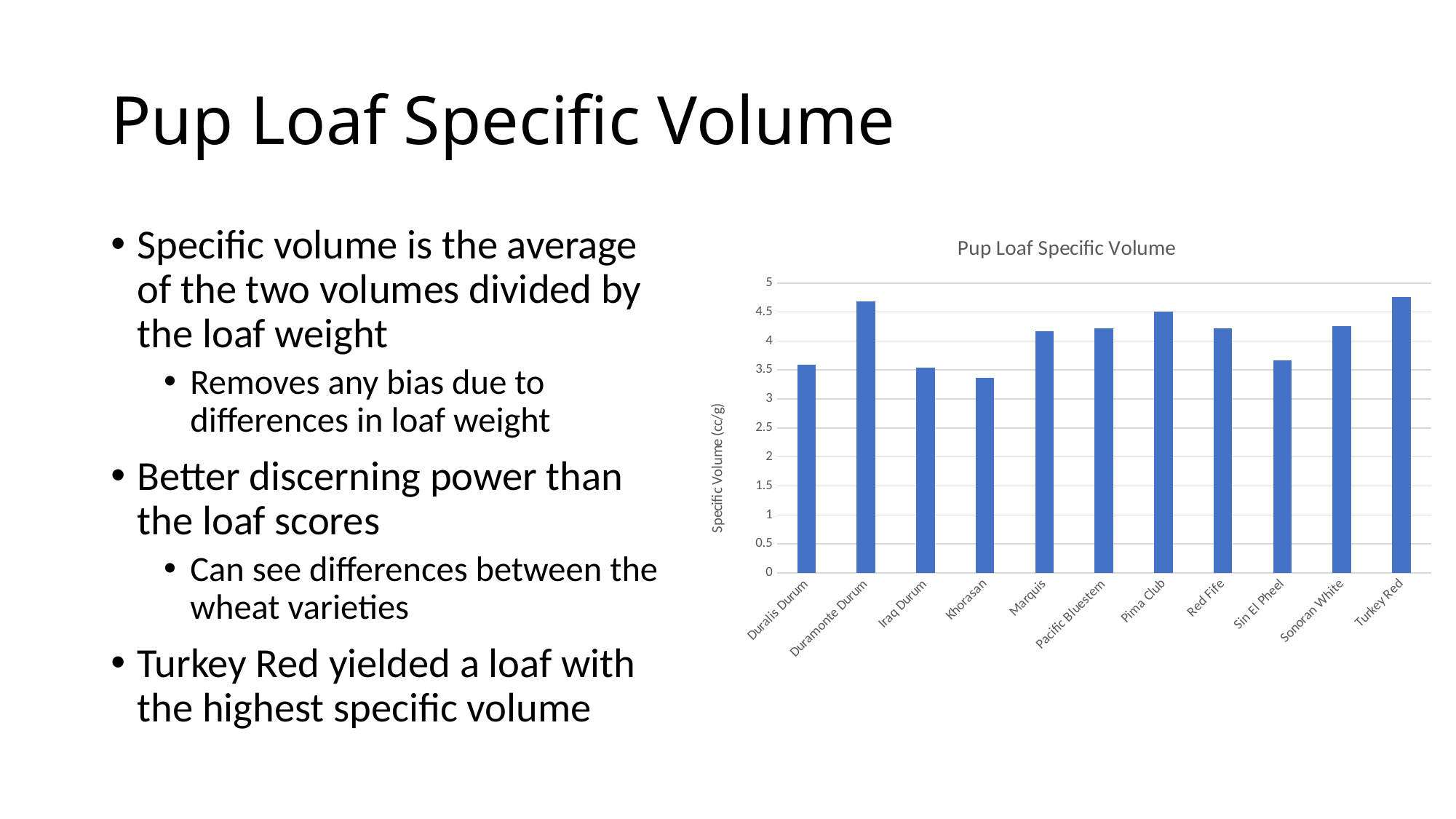
How many wheat varieties are plotted in the chart? 11 Is the value for Duramonte Durum greater or less than 4.5? greater What is the label on the vertical axis of the chart? Specific Volume (cc/g) Is the value for Khorasan greater or less than 3.5? less Which wheat variety has the lowest specific volume? Khorasan Which has a higher specific volume, Duramonte Durum or Sin El Pheel? Duramonte Durum Which has a higher specific volume, Pima Club or Marquis? Pima Club What kind of chart is shown on the slide? bar chart What is the title of the chart? Pup Loaf Specific Volume Which wheat variety has the highest specific volume? Turkey Red Is the value for Sin El Pheel greater or less than 4? less